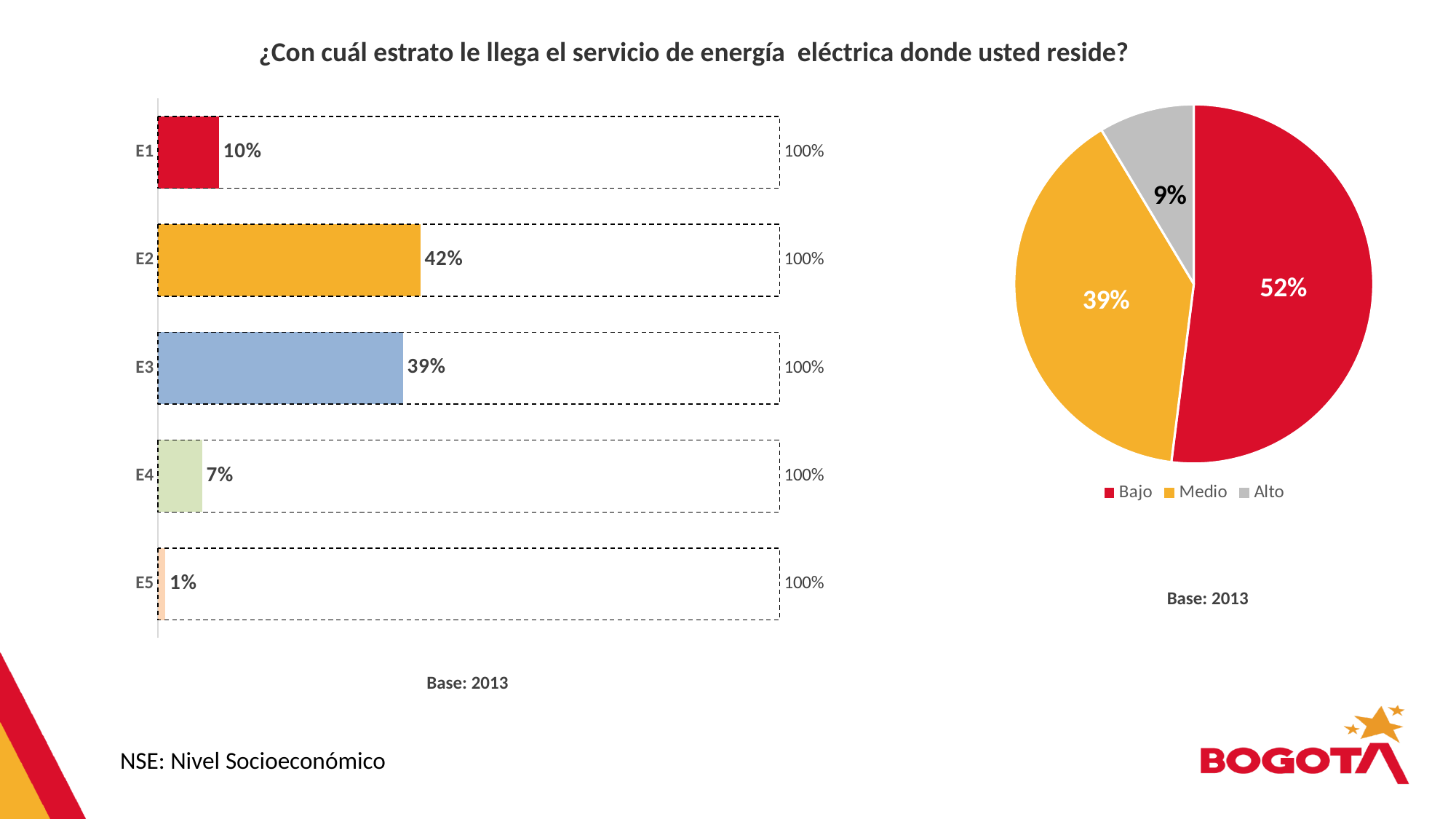
In the bar chart on the left, what is the value for E2? 42% How many categories does the bar chart on the left show? 5 In the pie chart on the right, which slice is the smallest? Alto In the pie chart on the right, what colour is the Medio slice? Orange In the bar chart on the left, which category has the lowest value? E5 In the bar chart on the left, what is the value for E4? 7% What kind of chart is the chart on the left? bar chart In the bar chart on the left, which is larger, the value for E1 or the value for E4? E1 In the bar chart on the left, which category has the highest value? E2 In the pie chart on the right, what share does Bajo have? 52% How many entries does the legend of the pie chart on the right list? 3 In the bar chart on the left, what is the difference between the values for E2 and E3? 3%